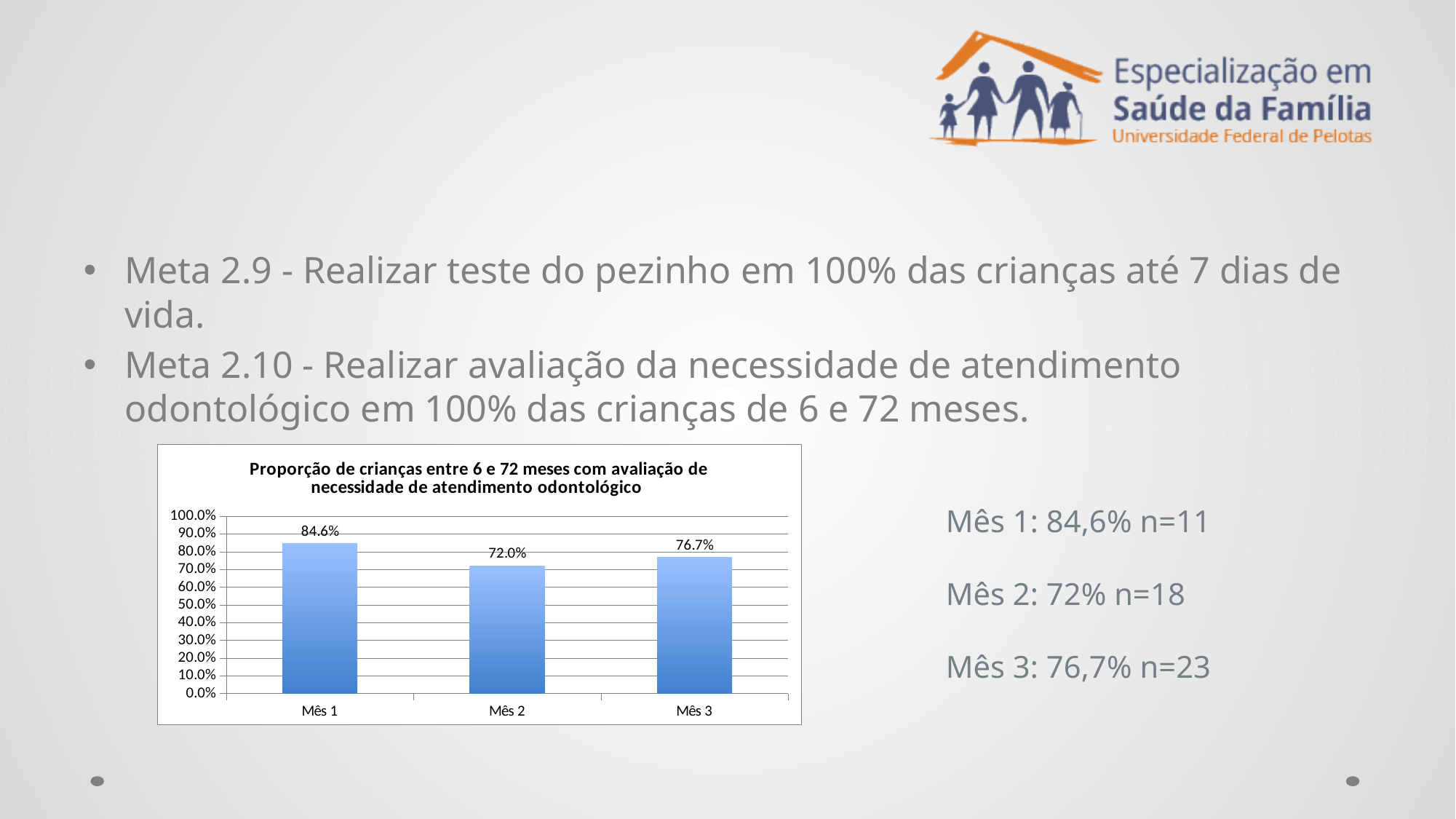
How many months are shown on the x axis? 3 What is the value for Mês 1? 84.6% What is the difference between the values for Mês 1 and Mês 2? 12.6% Is the value for Mês 2 greater or less than 80.0%? less Which month has the lowest value? Mês 2 What is the value for Mês 2? 72.0% What is the value for Mês 3? 76.7% Which is larger, the value for Mês 1 or the value for Mês 3? Mês 1 What kind of chart is shown on the slide? bar chart What is the difference between the values for Mês 3 and Mês 2? 4.7% What is the title of the chart? Proporção de crianças entre 6 e 72 meses com avaliação de necessidade de atendimento odontológico Which month has the highest value? Mês 1